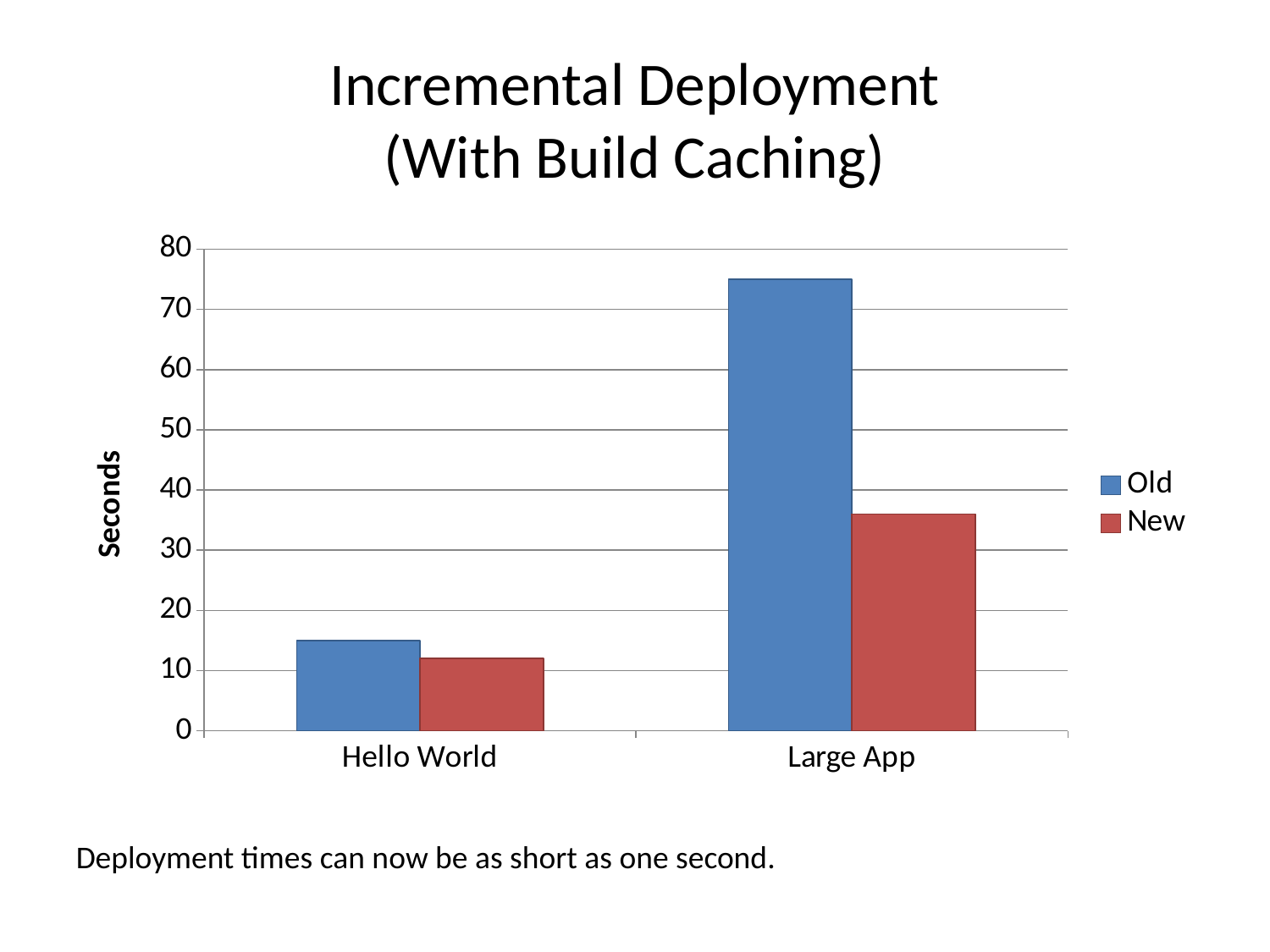
What colour are the bars for the New series? red What is the label on the vertical axis? Seconds What kind of chart is shown on the slide? bar chart How many series does the legend list? 2 Which category has the lowest New value? Hello World Is the New value for Hello World greater or less than 10? greater Is the Old value for Hello World greater or less than 20? less Which category has the highest Old value? Large App Is the New value for Large App greater or less than 40? less For Large App, which is larger, the Old value or the New value? Old How many categories are shown on the x axis? 2